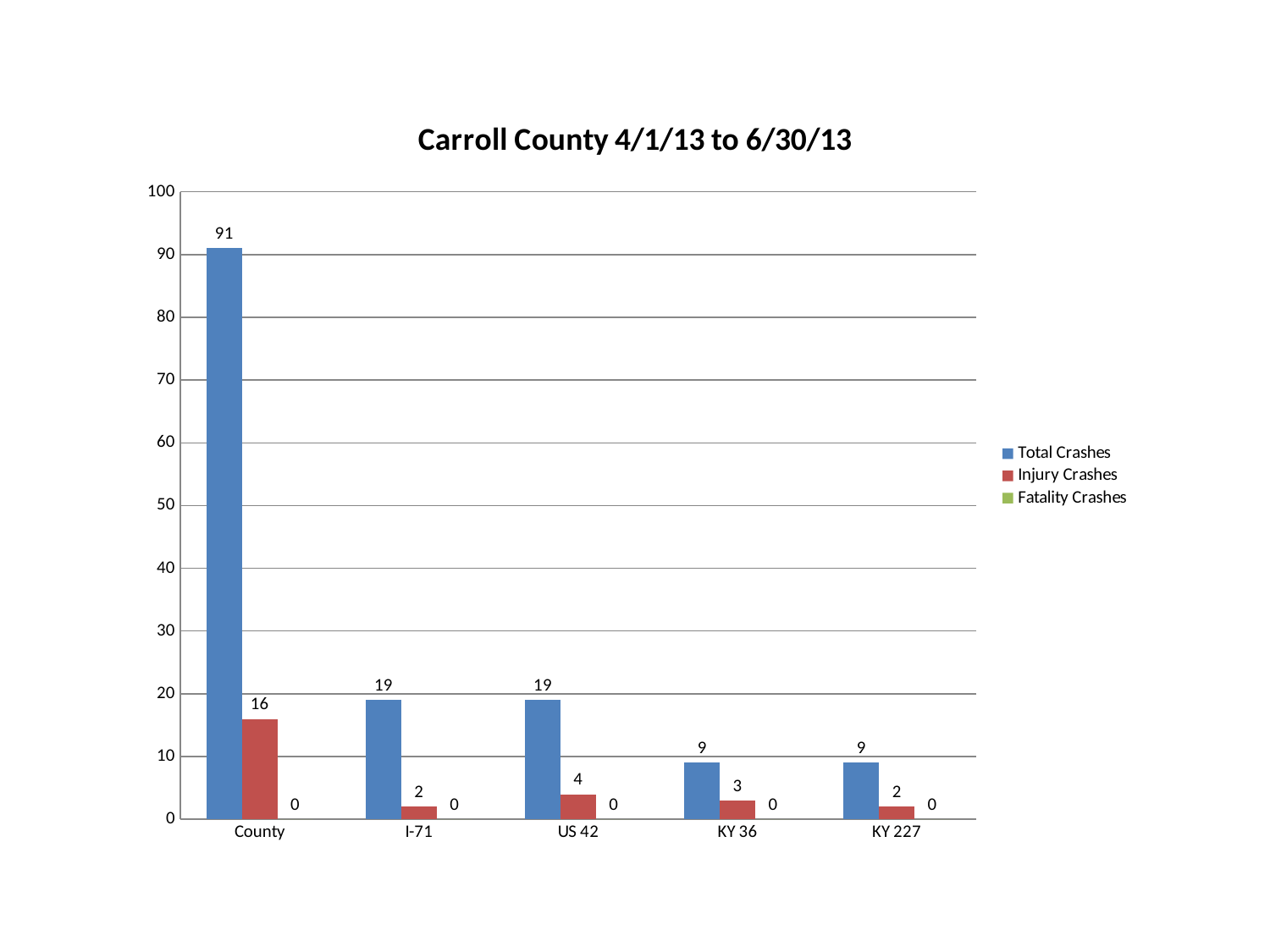
What kind of chart is shown on the slide? bar chart What is the difference between Total Crashes for County and Total Crashes for I-71? 72 What is the value of Injury Crashes for US 42? 4 What is the title of the chart? Carroll County 4/1/13 to 6/30/13 Which is larger: Injury Crashes for KY 36 or Injury Crashes for KY 227? KY 36 Is the value of Total Crashes for County greater or less than 80? greater How many categories are shown on the x axis? 5 How many series does the legend list? 3 What is the value of Fatality Crashes for KY 36? 0 Which category has the highest Total Crashes? County What is the value of Total Crashes for County? 91 Which category has the lowest Injury Crashes? I-71 and KY 227